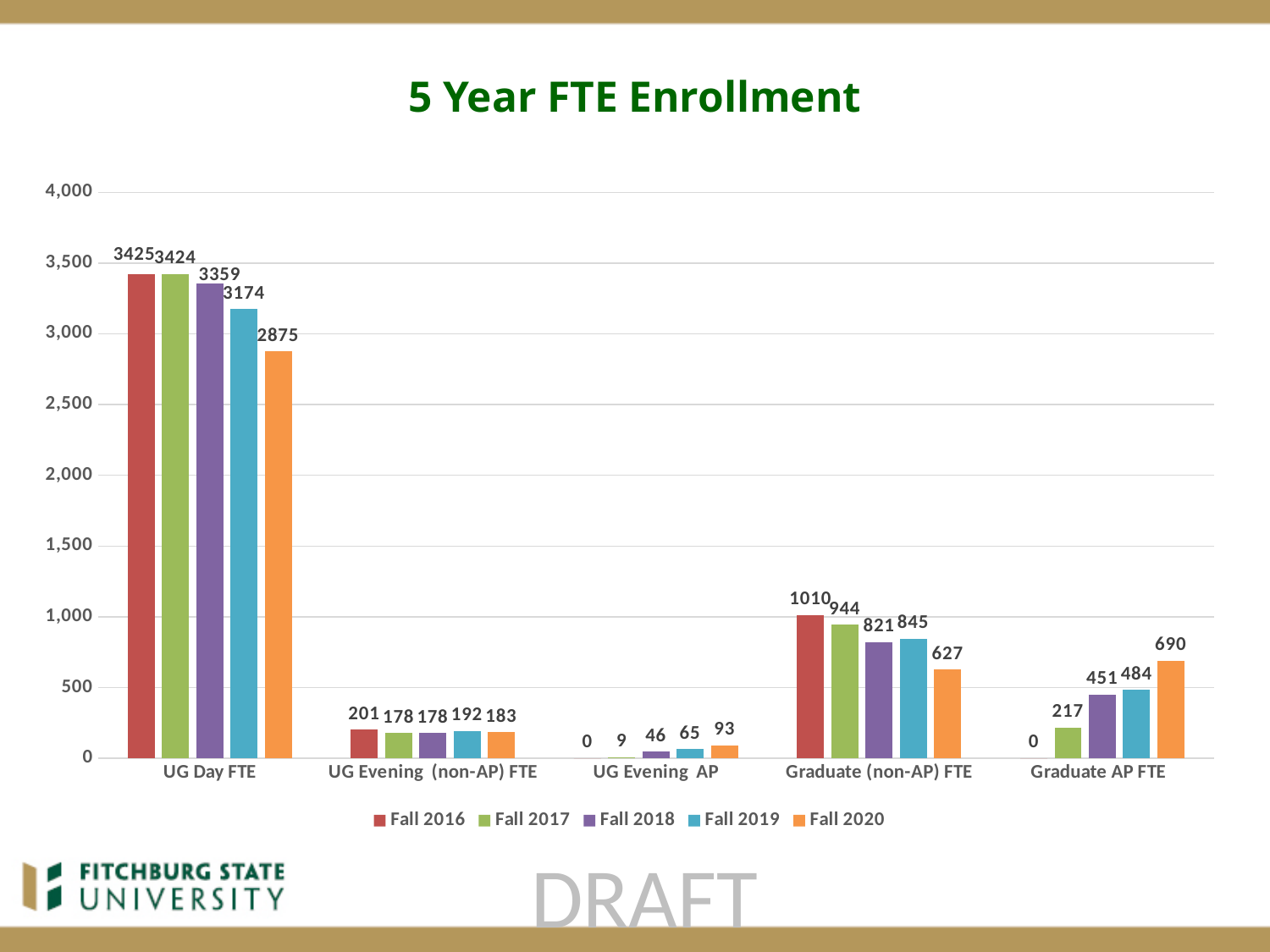
How many series does the legend list? 5 Do the UG Evening AP values rise or fall from Fall 2016 to Fall 2020? Rise What kind of chart is shown on the slide? Bar chart What is the Graduate AP FTE value for Fall 2019? 484 What is the Graduate (non-AP) FTE value for Fall 2016? 1010 What is the UG Day FTE value for Fall 2020? 2875 Which is larger, the Graduate (non-AP) FTE value for Fall 2018 or for Fall 2019? Fall 2019 What is the difference between the UG Day FTE values for Fall 2016 and Fall 2020? 550 Which year has the lowest UG Day FTE value? Fall 2020 What is the UG Evening AP value for Fall 2018? 46 How many categories are shown on the x axis? 5 Which year has the highest Graduate AP FTE value? Fall 2020